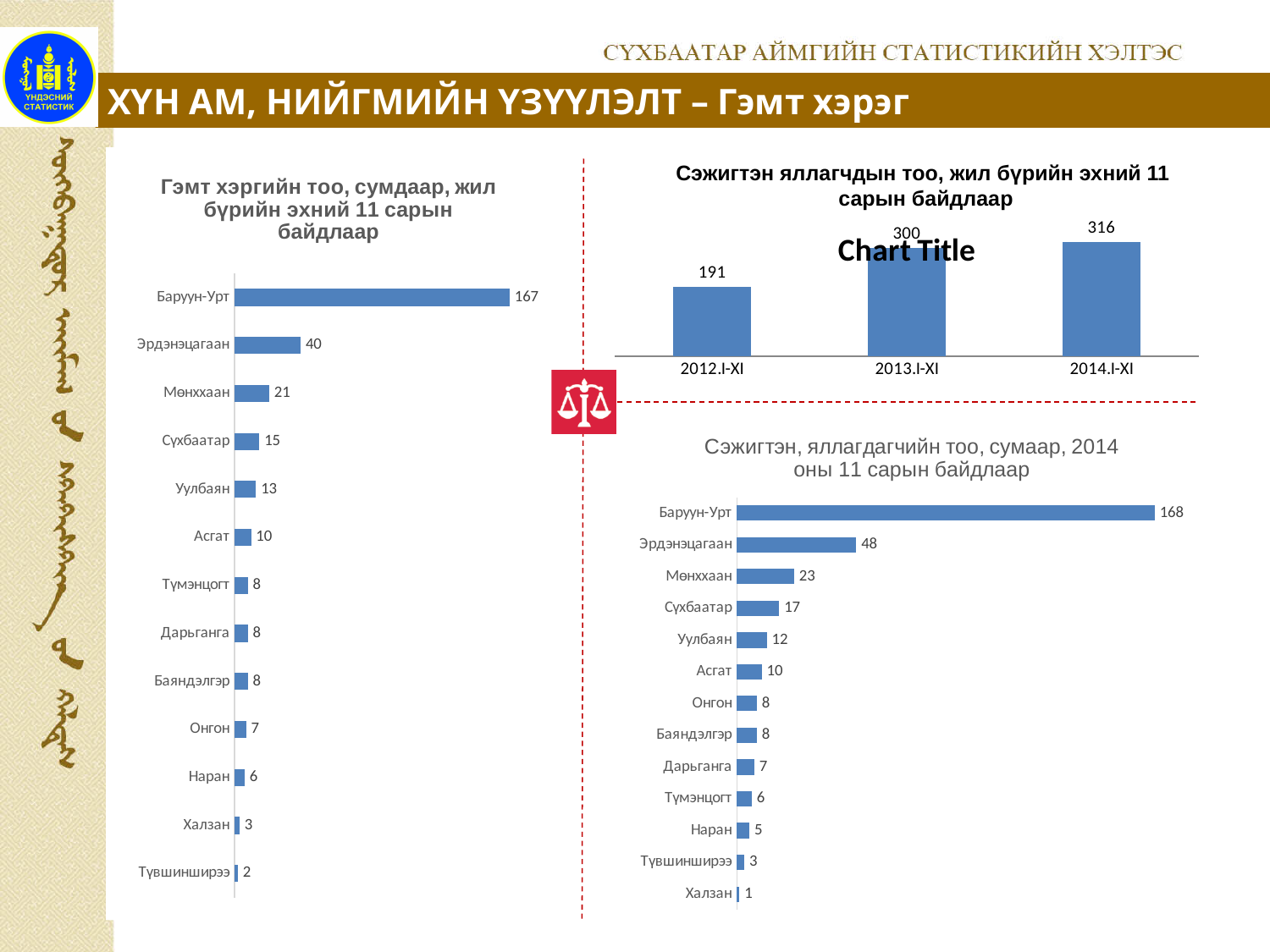
In the top right chart (Сэжигтэн яллагчдын тоо), what is the value for 2013.I-XI? 300 In the top right chart (Сэжигтэн яллагчдын тоо), what is the difference between 2014.I-XI and 2012.I-XI? 125 In the top right chart (Сэжигтэн яллагчдын тоо), do the values rise or fall from 2012.I-XI to 2014.I-XI? rise In the left chart (Гэмт хэргийн тоо, сумдаар), which category has the lowest value? Түвшинширээ In the left chart (Гэмт хэргийн тоо, сумдаар), what is the difference between Эрдэнэцагаан and Мөнххаан? 19 In the bottom right chart (Сэжигтэн, яллагдагчийн тоо, сумаар, 2014), which category has the highest value? Баруун-Урт What kind of chart is the top right chart (Сэжигтэн яллагчдын тоо)? bar chart In the left chart (Гэмт хэргийн тоо, сумдаар), how many categories are shown? 13 In the bottom right chart (Сэжигтэн, яллагдагчийн тоо, сумаар, 2014), what is the value for Эрдэнэцагаан? 48 In the bottom right chart (Сэжигтэн, яллагдагчийн тоо, сумаар, 2014), what is the value for Халзан? 1 In the bottom right chart (Сэжигтэн, яллагдагчийн тоо, сумаар, 2014), which is larger, Сүхбаатар or Уулбаян? Сүхбаатар In the left chart (Гэмт хэргийн тоо, сумдаар), what is the value for Баруун-Урт? 167